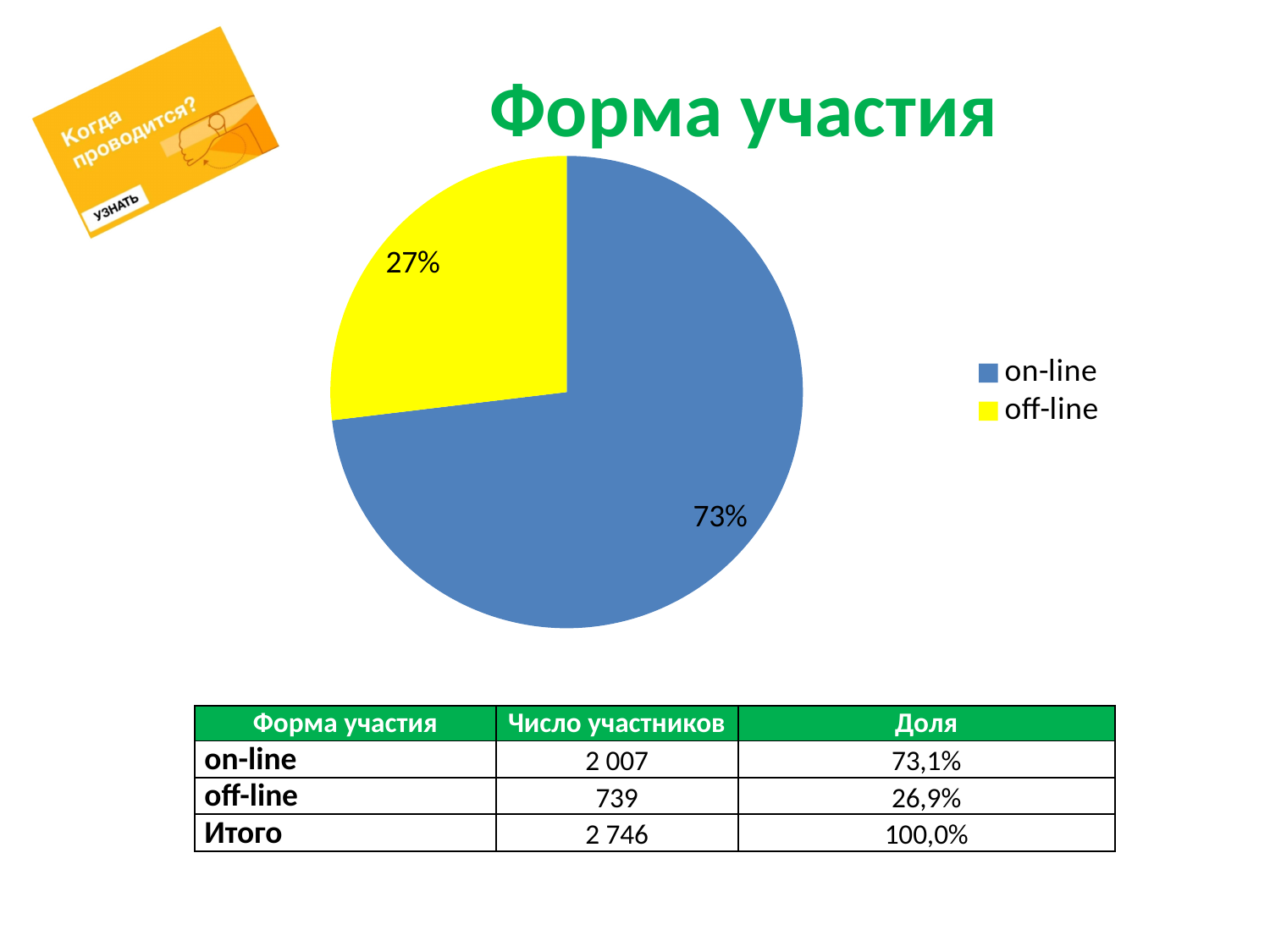
What colour is the off-line slice in the pie chart? yellow Which slice of the pie is the smallest? off-line What is the title of the chart? Форма участия Which is larger, the on-line slice or the off-line slice? on-line What share of the pie does the off-line slice represent? 27% What share of the pie does the on-line slice represent? 73% How many slices does the pie chart have? 2 How many entries does the legend list? 2 Which slice of the pie is the largest? on-line Is the share of the on-line slice greater or less than 50%? greater What kind of chart is shown on the slide? pie chart What is the difference in percentage points between the on-line and off-line slices? 46